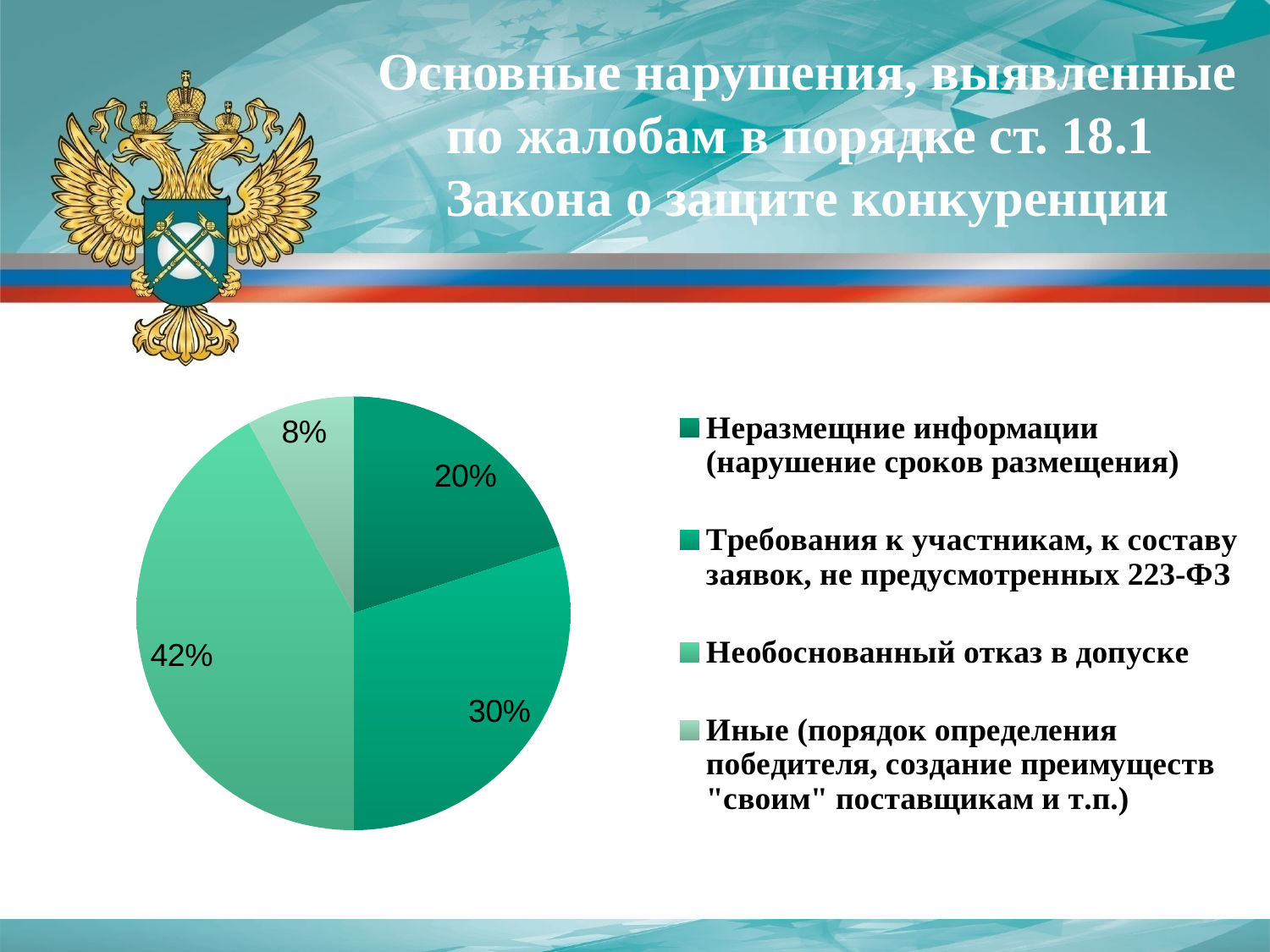
Which slice is larger: "Неразмещние информации (нарушение сроков размещения)" or "Требования к участникам, к составу заявок, не предусмотренных 223-ФЗ"? Требования к участникам, к составу заявок, не предусмотренных 223-ФЗ Which category has the largest slice of the pie? Необоснованный отказ в допуске What share of the pie does "Неразмещние информации (нарушение сроков размещения)" take? 20% How many entries does the legend of the pie chart list? 4 What share of the pie does "Иные (порядок определения победителя, создание преимуществ "своим" поставщикам и т.п.)" take? 8% What is the title of the slide containing the pie chart? Основные нарушения, выявленные по жалобам в порядке ст. 18.1 Закона о защите конкуренции What kind of chart is shown on the slide? pie chart Which category has the smallest slice of the pie? Иные (порядок определения победителя, создание преимуществ "своим" поставщикам и т.п.) What share of the pie does "Необоснованный отказ в допуске" take? 42% How many slices does the pie chart have? 4 What is the difference in percentage points between the "Необоснованный отказ в допуске" slice and the "Требования к участникам, к составу заявок, не предусмотренных 223-ФЗ" slice? 12